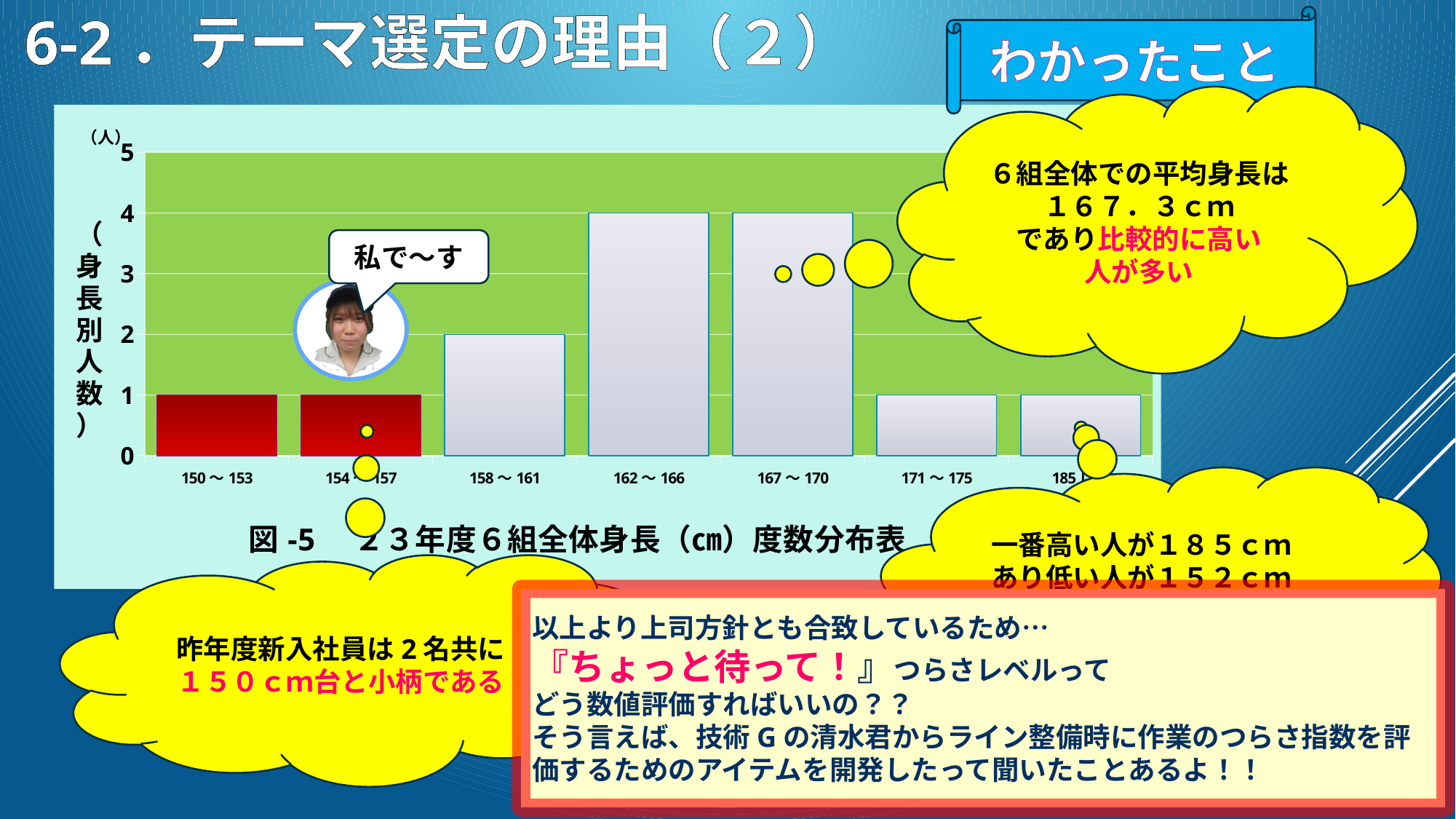
What is the number of people in the 158～161 height category? 2 What is the number of people in the 171～175 height category? 1 What is the figure caption (title) of the chart? 図-5 ２３年度６組全体身長（cm）度数分布表 What is the number of people in the 167～170 height category? 4 What kind of chart is shown on the slide? bar chart What is the difference in number of people between the 167～170 category and the 171～175 category? 3 Is the value for the 162～166 category greater or less than 3? greater What is the number of people in the 162～166 height category? 4 How many height categories are shown on the x axis of the chart? 7 Which has more people, the 162～166 category or the 158～161 category? 162～166 What is the number of people in the 150～153 height category? 1 What is the maximum value shown on the y axis of the chart? 5